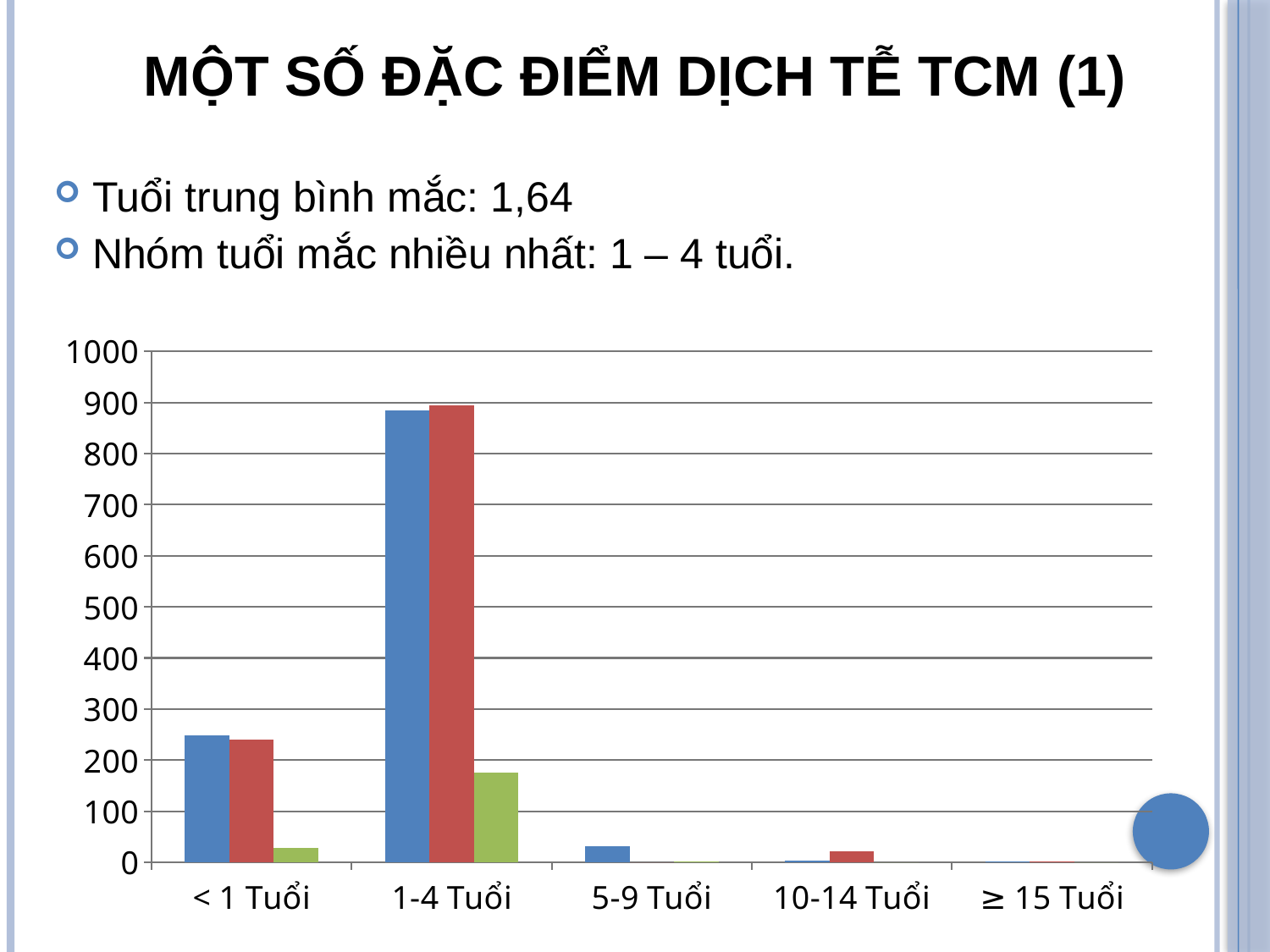
Is the value of the blue bar for 1-4 Tuổi greater or less than 800? greater Which age group has the tallest bars in the chart? 1-4 Tuổi What kind of chart is shown on the slide? bar chart How many age-group categories are shown on the x axis of the chart? 5 Is the value of the blue bar for < 1 Tuổi greater or less than 200? greater Is the value of the blue bar for 5-9 Tuổi greater or less than 100? less What is the highest value shown on the chart's vertical axis? 1000 Which is larger: the blue bar for 1-4 Tuổi or the blue bar for < 1 Tuổi? 1-4 Tuổi Which is larger: the green bar for < 1 Tuổi or the green bar for 1-4 Tuổi? 1-4 Tuổi